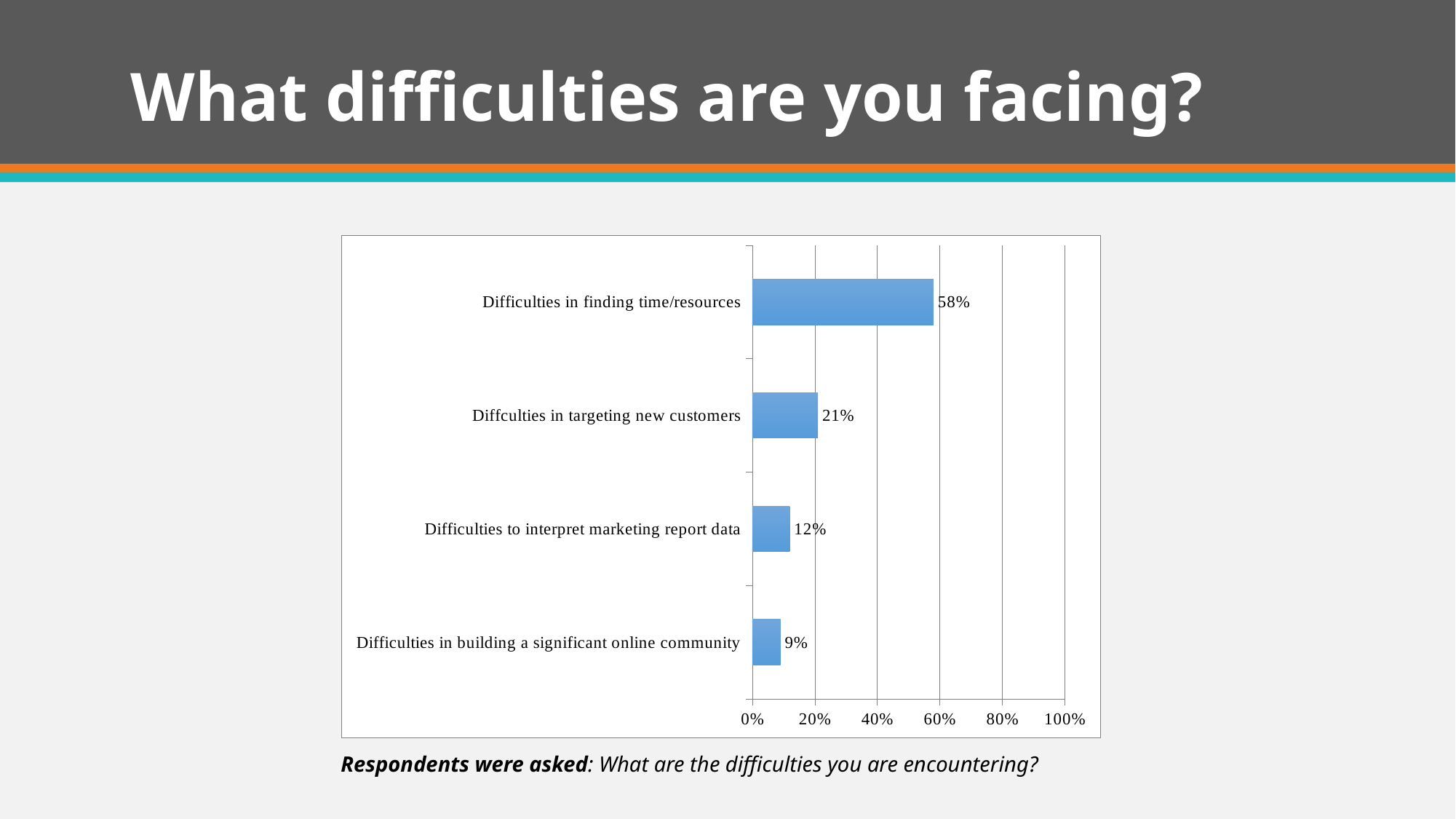
Is the value for 'Difficulties in finding time/resources' greater or less than 40%? greater What percentage is shown for 'Difficulties to interpret marketing report data'? 12% What is the difference between the value for interpreting marketing report data and the value for building a significant online community? 3% What is the difference between the value for finding time/resources and the value for targeting new customers? 37% How many difficulty categories are shown in the chart? 4 What type of chart is shown on the slide? Bar chart Which difficulty has the lowest percentage? Difficulties in building a significant online community What is the value for 'Difficulties in building a significant online community'? 9% What is the value for 'Diffculties in targeting new customers'? 21% What percentage of respondents reported difficulties in finding time/resources? 58% Which difficulty has the highest percentage? Difficulties in finding time/resources Which is larger: the value for targeting new customers or the value for interpreting marketing report data? Diffculties in targeting new customers